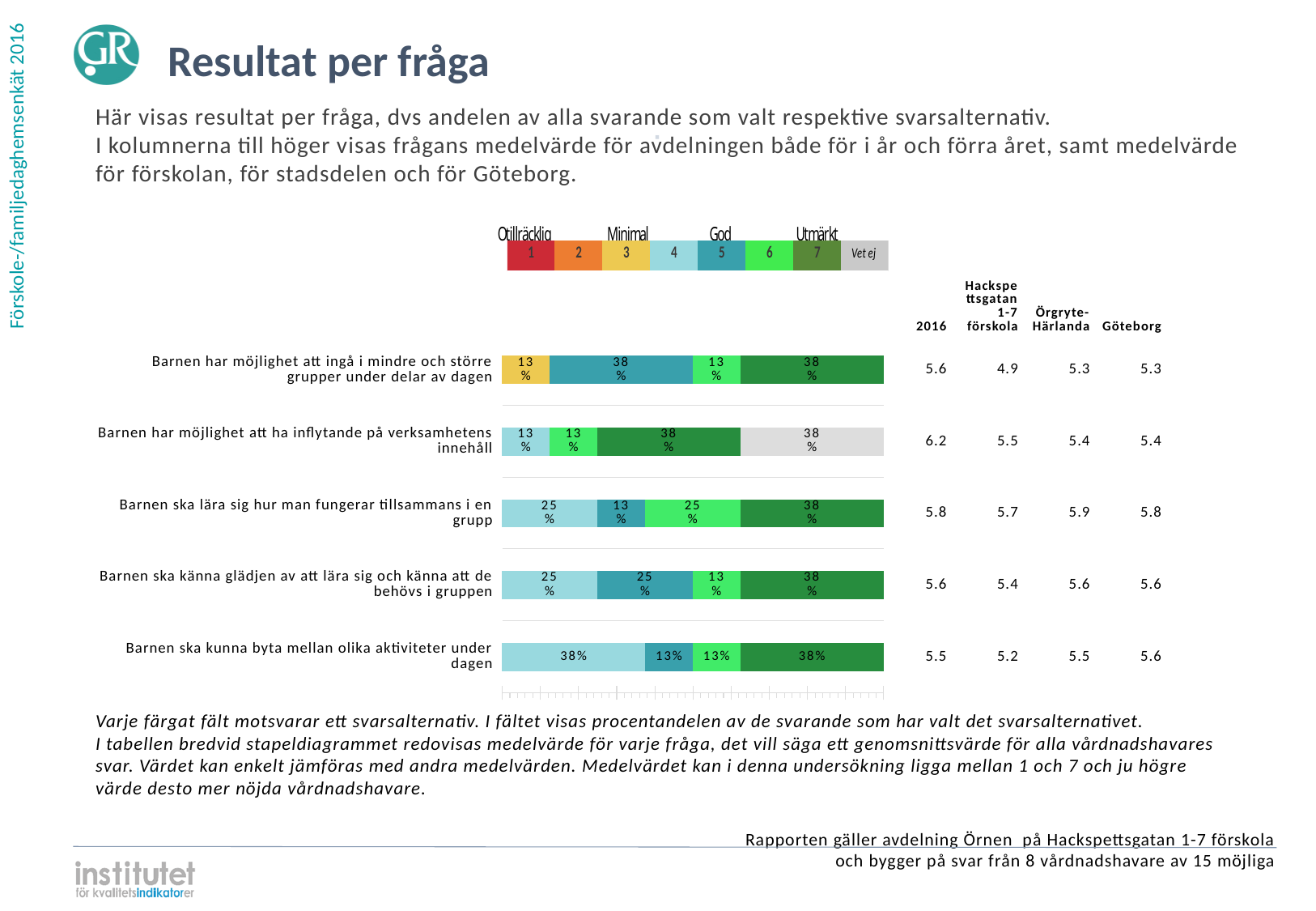
What percentage is shown in the light blue segment for "Barnen ska kunna byta mellan olika aktiviteter under dagen"? 38% What percentage is shown in the grey (Vet ej) segment for "Barnen har möjlighet att ha inflytande på verksamhetens innehåll"? 38% Which question has the highest 2016 mean value? Barnen har möjlighet att ha inflytande på verksamhetens innehåll For "Barnen ska lära sig hur man fungerar tillsammans i en grupp", what is the difference between the light blue segment (25%) and the teal segment (13%)? 12 percentage points What are the four scale labels shown above the colour legend? Otillräcklig, Minimal, God, Utmärkt For "Barnen har möjlighet att ingå i mindre och större grupper under delar av dagen", which is larger: the yellow segment or the teal segment? The teal segment How many questions (bars) are shown in the chart? 5 For "Barnen har möjlighet att ingå i mindre och större grupper under delar av dagen", which is higher: the 2016 mean or the Hackspettsgatan 1-7 förskola mean? 2016 What kind of chart is used to show the results per question? Stacked bar chart What is the 2016 mean value for "Barnen har möjlighet att ha inflytande på verksamhetens innehåll"? 6.2 Which question has the lowest 2016 mean value? Barnen ska kunna byta mellan olika aktiviteter under dagen What is the Göteborg mean value for "Barnen ska kunna byta mellan olika aktiviteter under dagen"? 5.6